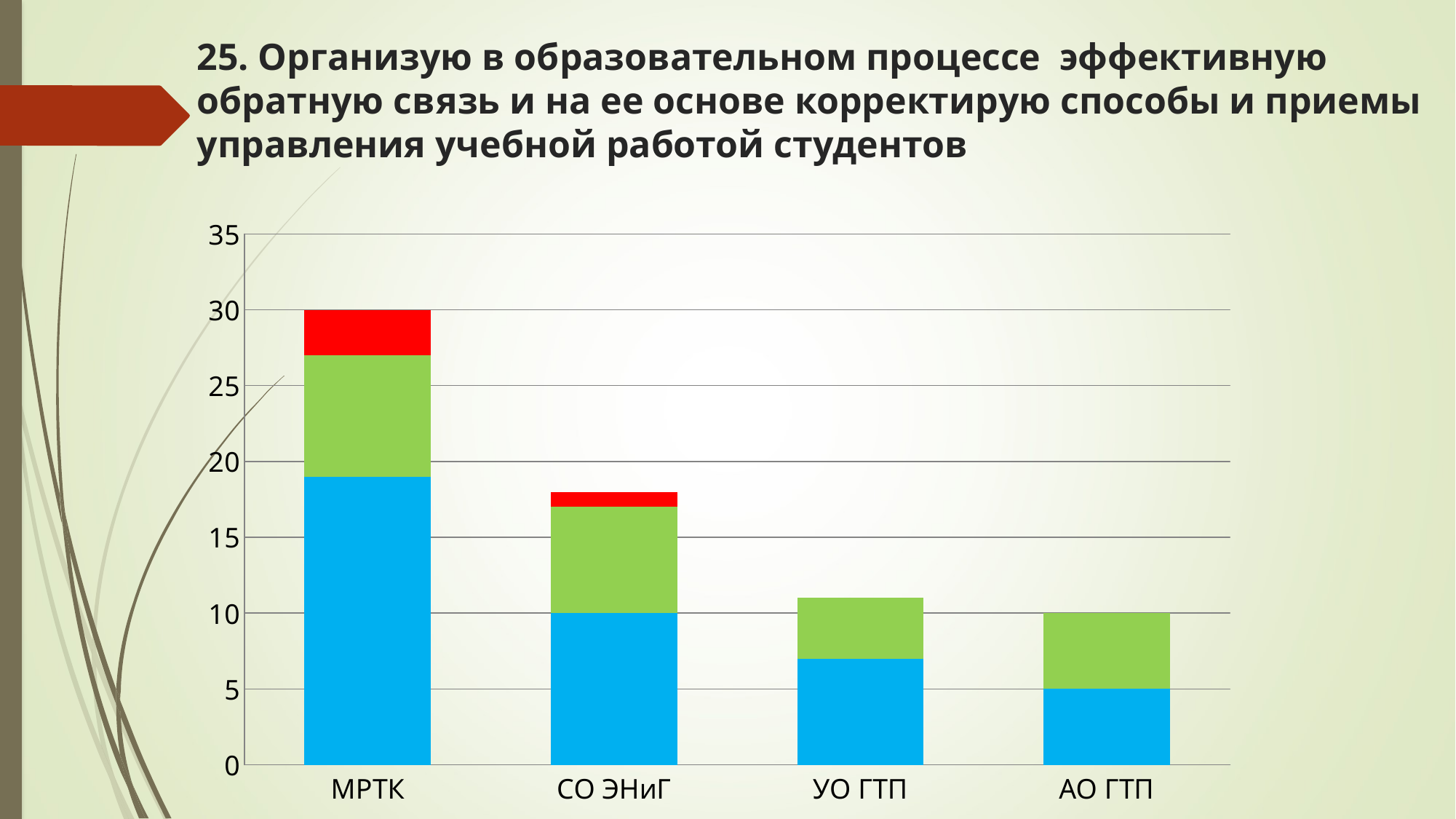
Is the total value for УО ГТП greater or less than 15? less What is the total height of the bar for АО ГТП? 10 How many categories are shown on the x axis of the chart? 4 Is the total value for СО ЭНиГ greater or less than 15? greater Which category has the shortest bar in the chart? АО ГТП Which bar is taller, СО ЭНиГ or УО ГТП? СО ЭНиГ What kind of chart is shown on the slide? stacked bar chart What is the total height of the bar for МРТК? 30 Which categories have a red segment at the top of their bar? МРТК and СО ЭНиГ Do the total bar heights rise or fall from left to right across the categories? fall Which category has the tallest bar in the chart? МРТК What is the difference between the total bar heights for МРТК and АО ГТП? 20